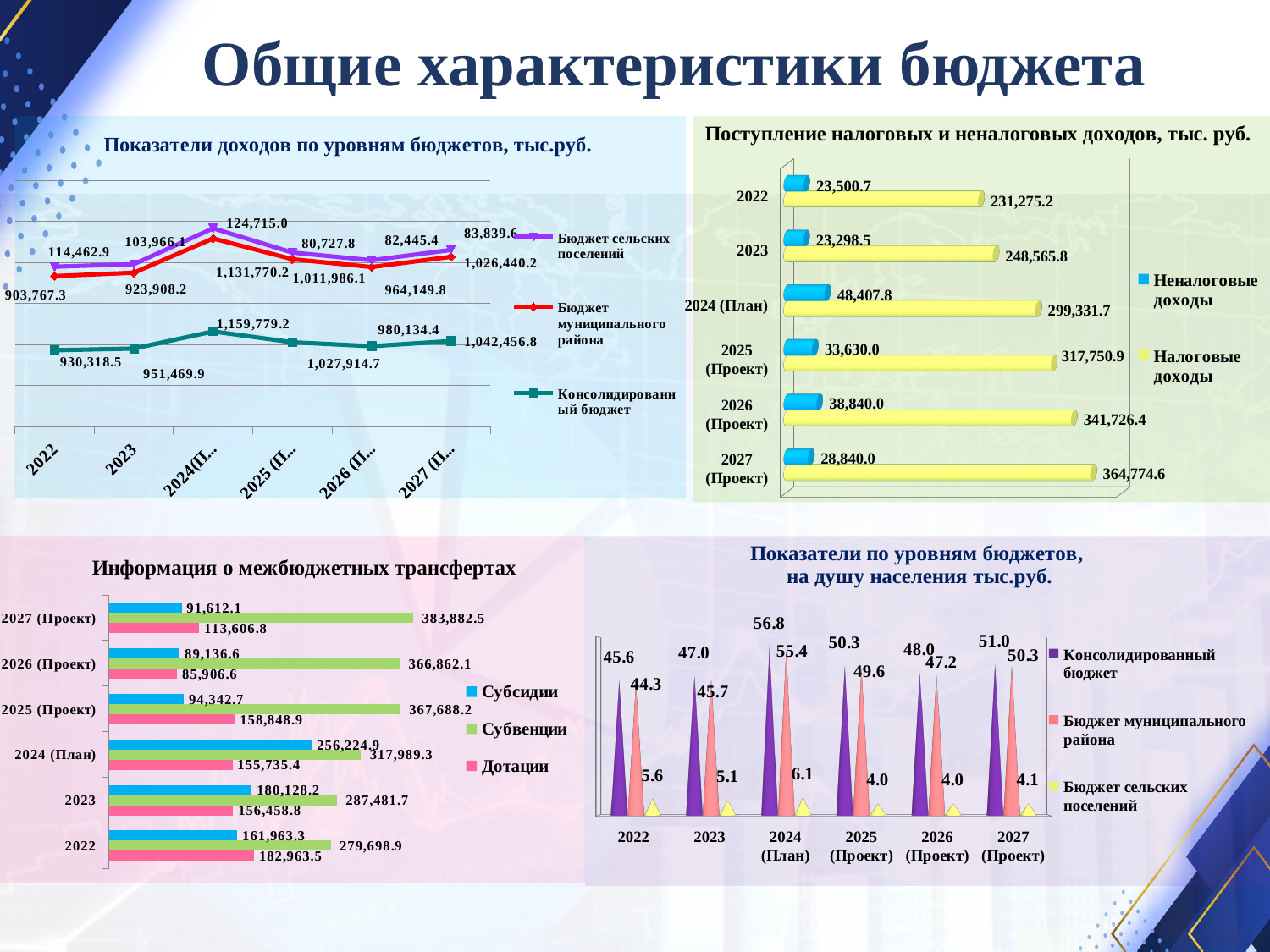
In the chart 'Поступление налоговых и неналоговых доходов, тыс. руб.', which year has the highest value of Неналоговые доходы? 2024 (План) In the chart 'Показатели доходов по уровням бюджетов, тыс.руб.', which year has the lowest value for Бюджет сельских поселений? 2025 (Проект) In the chart 'Показатели по уровням бюджетов, на душу населения тыс.руб.', what is the value of Консолидированный бюджет for 2024 (План)? 56.8 In the chart 'Поступление налоговых и неналоговых доходов, тыс. руб.', what is the value of Налоговые доходы for 2027 (Проект)? 364,774.6 In the chart 'Информация о межбюджетных трансфертах', what is the difference between Субвенции for 2027 (Проект) and Субвенции for 2026 (Проект)? 17,020.4 In the chart 'Информация о межбюджетных трансфертах', which is larger for 2022: Субсидии or Дотации? Дотации In the chart 'Показатели доходов по уровням бюджетов, тыс.руб.', what is the value of Консолидированный бюджет for 2022? 930,318.5 In the chart 'Информация о межбюджетных трансфертах', what is the value of Субвенции for 2024 (План)? 317,989.3 What kind of chart is 'Показатели доходов по уровням бюджетов, тыс.руб.'? Line chart In the chart 'Информация о межбюджетных трансфертах', how many categories (years) are shown? 6 In the chart 'Показатели по уровням бюджетов, на душу населения тыс.руб.', which year has the highest value for Бюджет сельских поселений? 2024 (План) In the chart 'Поступление налоговых и неналоговых доходов, тыс. руб.', how many series does the legend list? 2